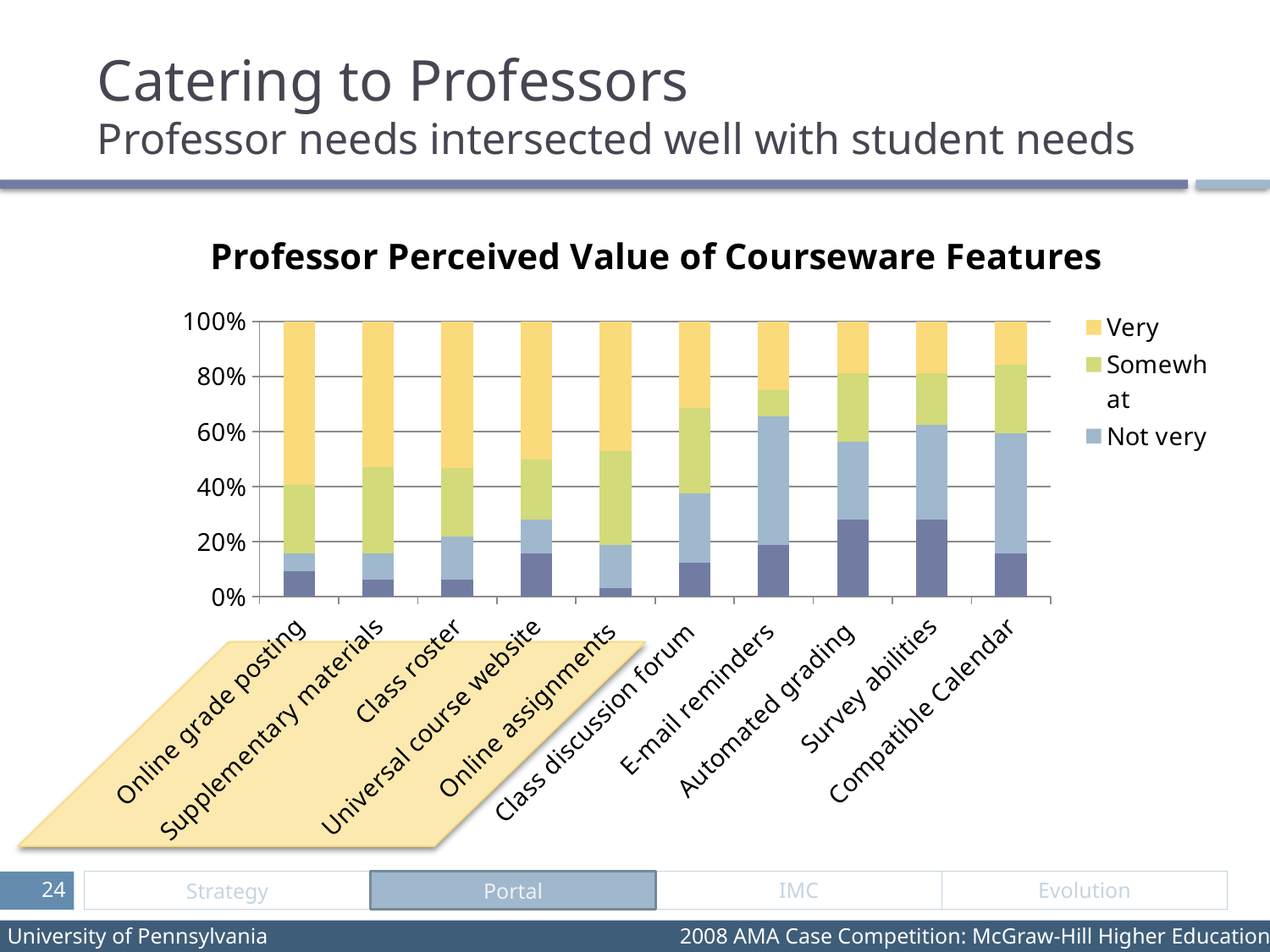
Is the "Very" share for Class discussion forum greater or less than 20%? greater What is the title of the chart? Professor Perceived Value of Courseware Features How many courseware features (categories) are shown on the x axis of the chart? 10 Is the "Very" share for Compatible Calendar greater or less than 20%? less Which feature has a larger "Very" share: Class roster or E-mail reminders? Class roster What kind of chart is shown on the slide? Stacked bar chart Is the "Very" share for Online grade posting greater or less than 40%? greater Which courseware feature has the largest "Very" share in the chart? Online grade posting Which feature has a larger "Very" share: Online grade posting or Compatible Calendar? Online grade posting Which colour represents the "Very" series in the chart? Yellow Does the "Very" share generally rise or fall moving from left to right across the features? Fall How many series does the chart's legend list? 3